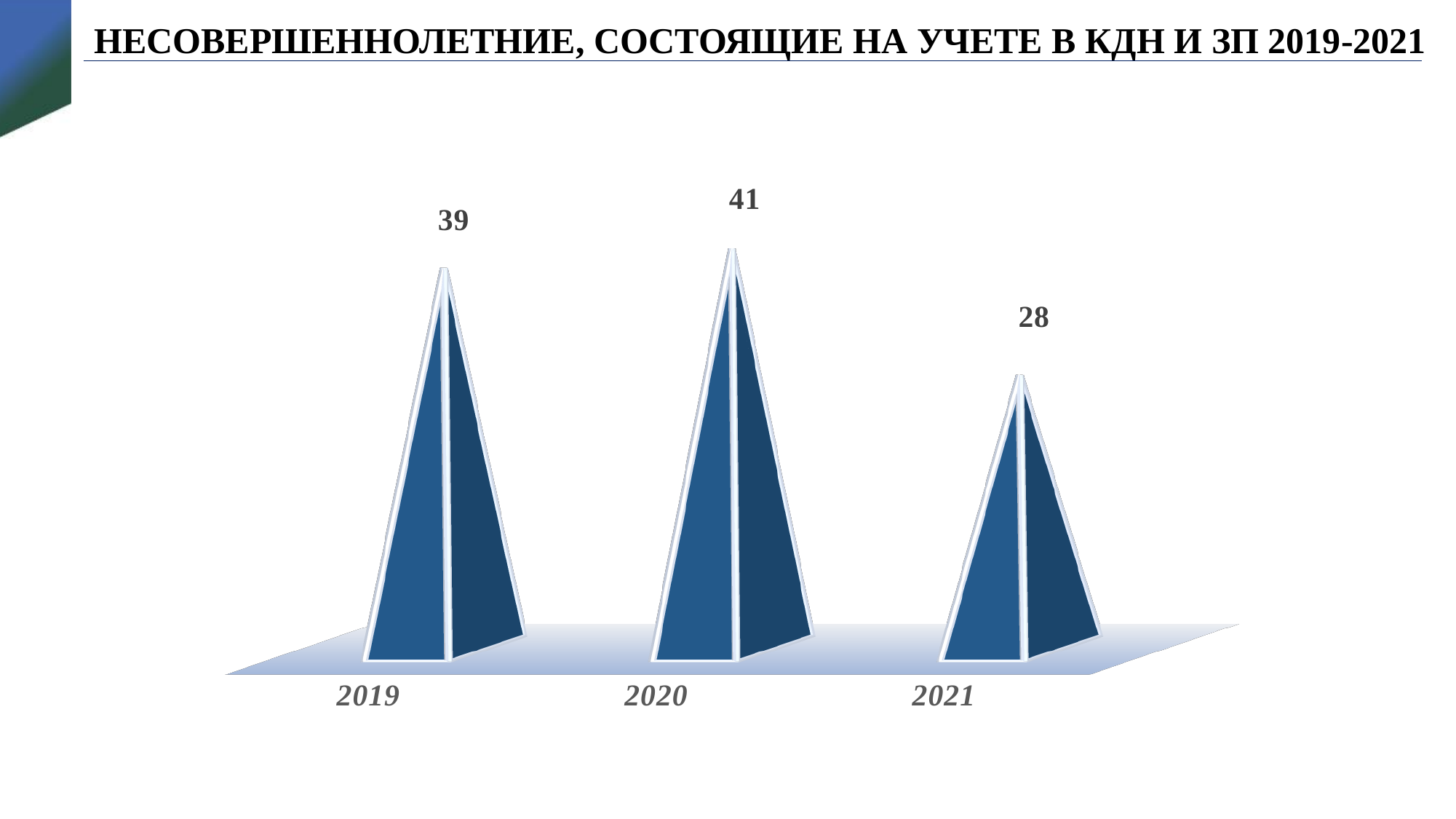
Which year has the highest value? 2020 What is the value for 2020? 41 What is the title of the chart? НЕСОВЕРШЕННОЛЕТНИЕ, СОСТОЯЩИЕ НА УЧЕТЕ В КДН И ЗП 2019-2021 Which year has the lowest value? 2021 What is the difference between the values for 2020 and 2019? 2 What is the value for 2021? 28 Does the value rise or fall from 2020 to 2021? fall What kind of chart is shown on the slide? bar chart What is the value for 2019? 39 How many years are shown on the chart? 3 What is the difference between the values for 2020 and 2021? 13 Which is larger, the value for 2019 or the value for 2021? 2019